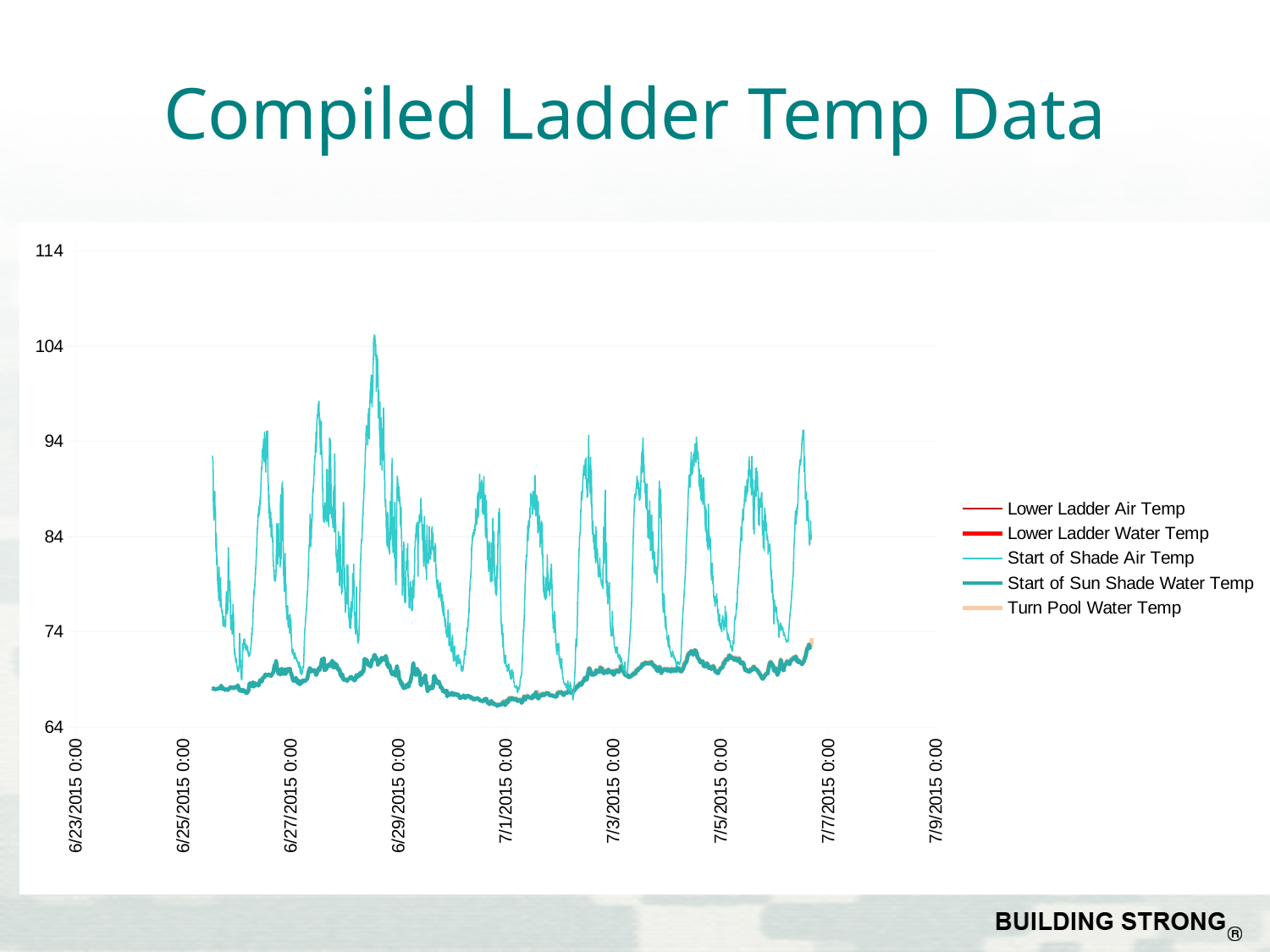
What is the title of the chart on the slide? Compiled Ladder Temp Data Is the lowest value reached by the Start of Shade Air Temp series greater or less than 64? greater Is the lowest value of the Start of Sun Shade Water Temp series greater or less than 64? greater Which series reaches higher values overall, Start of Shade Air Temp or Start of Sun Shade Water Temp? Start of Shade Air Temp Is the highest value reached by the Start of Shade Air Temp series greater or less than 94? greater How many date labels are shown along the x axis? 9 Around which x-axis date does the Start of Shade Air Temp series reach its highest peak? 6/29/2015 0:00 What is the first date label on the x axis? 6/23/2015 0:00 Which legend entry is drawn with a thick red line? Lower Ladder Water Temp What kind of chart is shown on the slide? line chart How many series does the chart's legend list? 5